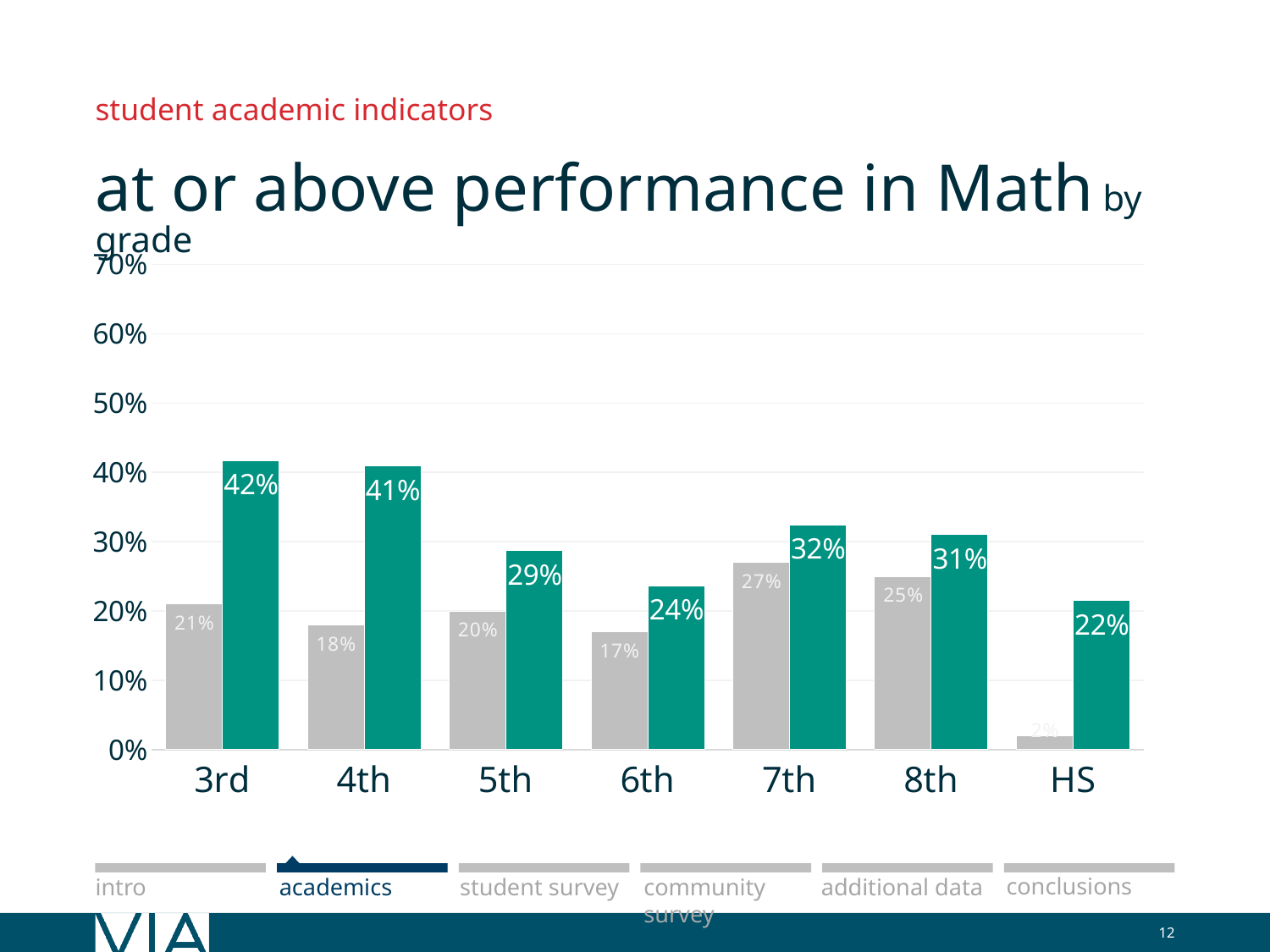
What is the difference between the teal bar and the gray bar for HS? 20% Which is larger for 6th grade, the gray bar or the teal bar? the teal bar What is the difference between the teal bar and the gray bar for 3rd grade? 21% Which grade has the highest teal bar? 3rd How many grade categories are shown on the x axis? 7 What is the value of the teal bar for HS? 22% Which grade has the lowest gray bar? HS What is the title of the chart? at or above performance in Math by grade Is the value of the teal bar for 4th grade greater or less than 40%? greater What is the value of the teal bar for 3rd grade? 42% What type of chart is shown on the slide? bar chart What is the value of the gray bar for 7th grade? 27%